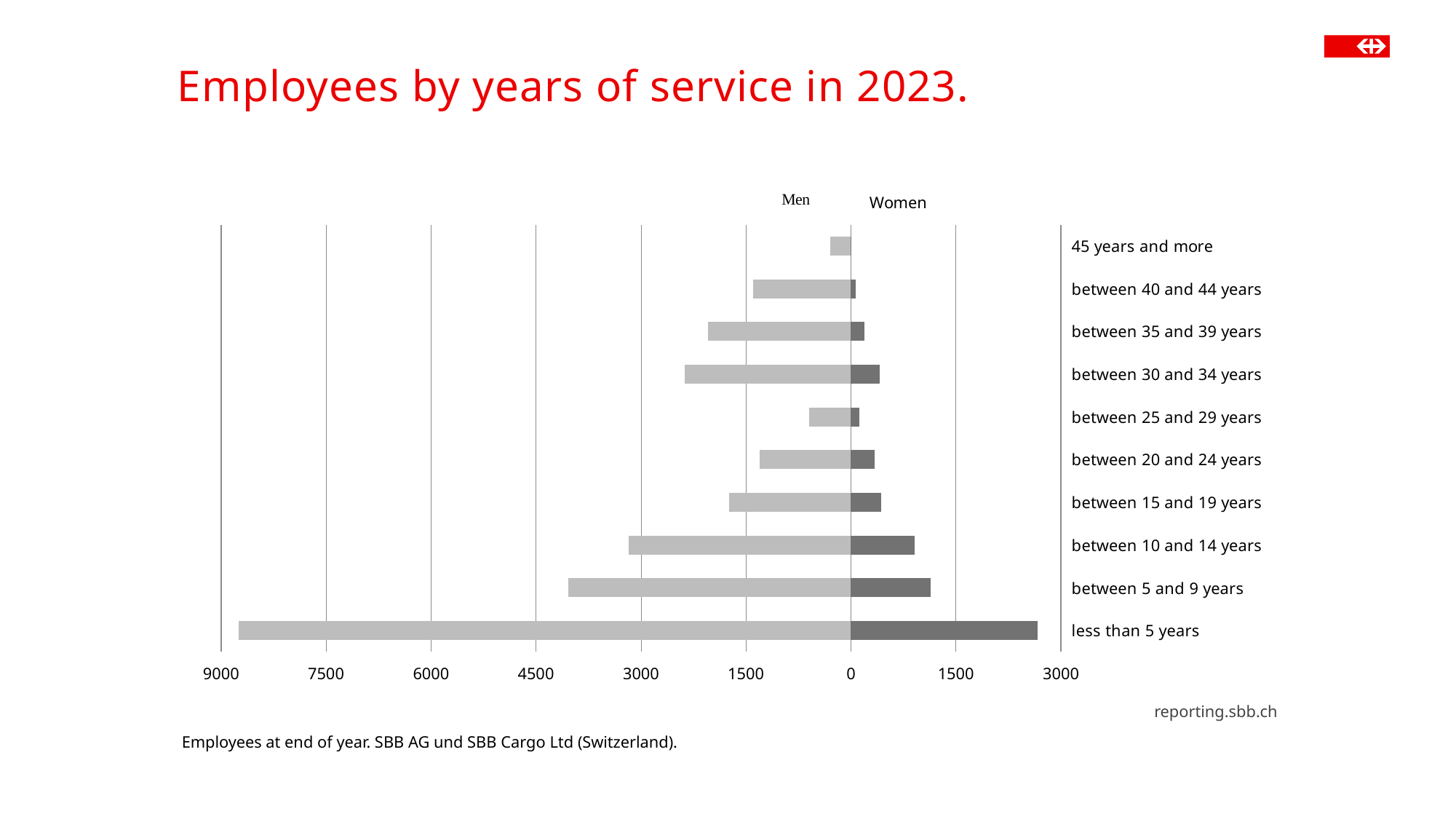
How many years-of-service categories are shown in the chart? 10 Is the number of men with less than 5 years of service greater or less than 7500? greater How many series does the chart show? 2 Is the number of men with between 5 and 9 years of service greater or less than 3000? greater Which years-of-service category has the lowest number of women? 45 years and more What is the title of the chart on the slide? Employees by years of service in 2023. Which is larger: the number of men with between 30 and 34 years of service or the number of men with between 25 and 29 years of service? between 30 and 34 years Which years-of-service category has the highest number of women? less than 5 years Which years-of-service category has the lowest number of men? 45 years and more Is the number of women with less than 5 years of service greater or less than 1500? greater Which years-of-service category has the highest number of men? less than 5 years What kind of chart is shown on the slide? bar chart